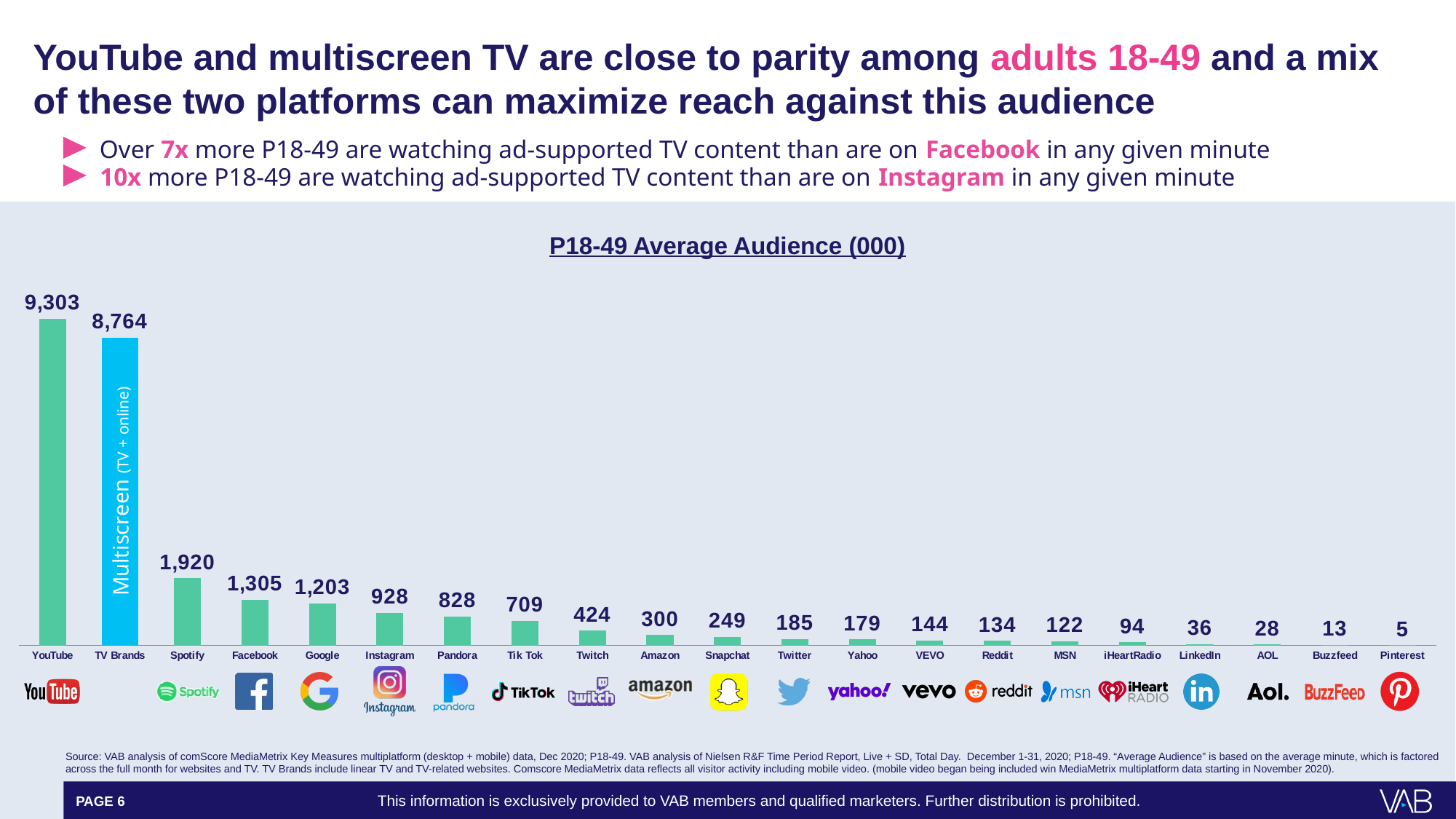
Which has a larger P18-49 average audience, Spotify or Facebook? Spotify What is the difference between the YouTube and TV Brands values? 539 Which bar in the chart is coloured differently (blue) from the others? TV Brands What is the P18-49 average audience (000) for Instagram? 928 Which category has the lowest P18-49 average audience? Pinterest What is the difference between the Facebook and Google values? 102 What type of chart is shown on the slide? Bar chart What is the P18-49 average audience (000) for Tik Tok? 709 What is the P18-49 average audience (000) for TV Brands? 8,764 How many categories are shown in the chart? 21 Which category has the highest P18-49 average audience? YouTube What is the P18-49 average audience (000) for YouTube? 9,303